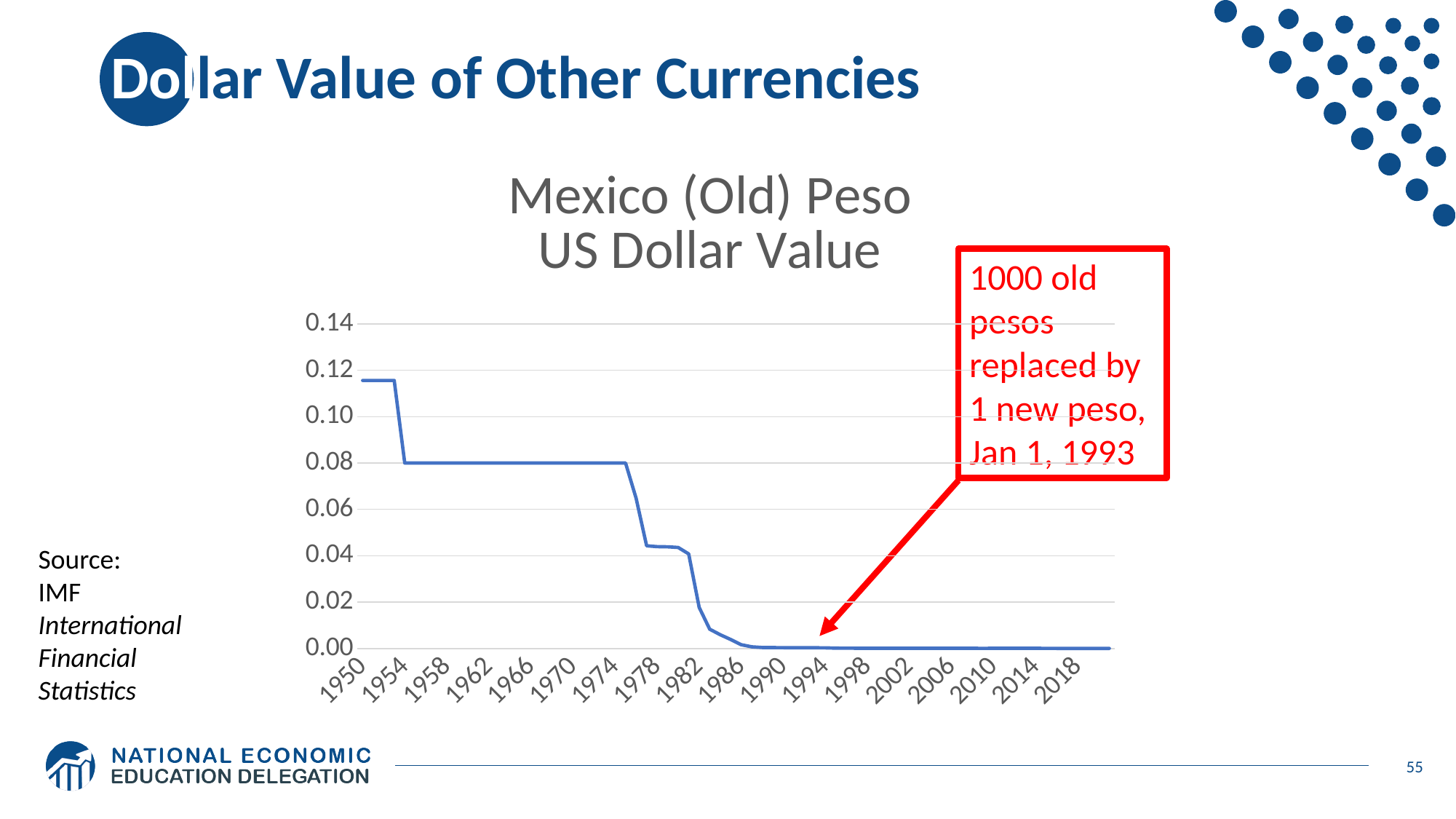
Is the value for 1950 greater or less than 0.10? greater Is the value for 2000 greater or less than 0.02? less What kind of chart is shown on the slide? line chart What is the title of the chart? Mexico (Old) Peso US Dollar Value Is the value for 1966 greater or less than 0.06? greater Which year has the higher value, 1950 or 1970? 1950 What is the highest value shown on the y axis? 0.14 Does the value of the Mexican old peso rise or fall over the period shown on the x axis? fall Which year has the higher value, 1978 or 1990? 1978 How many year labels are shown on the x axis? 18